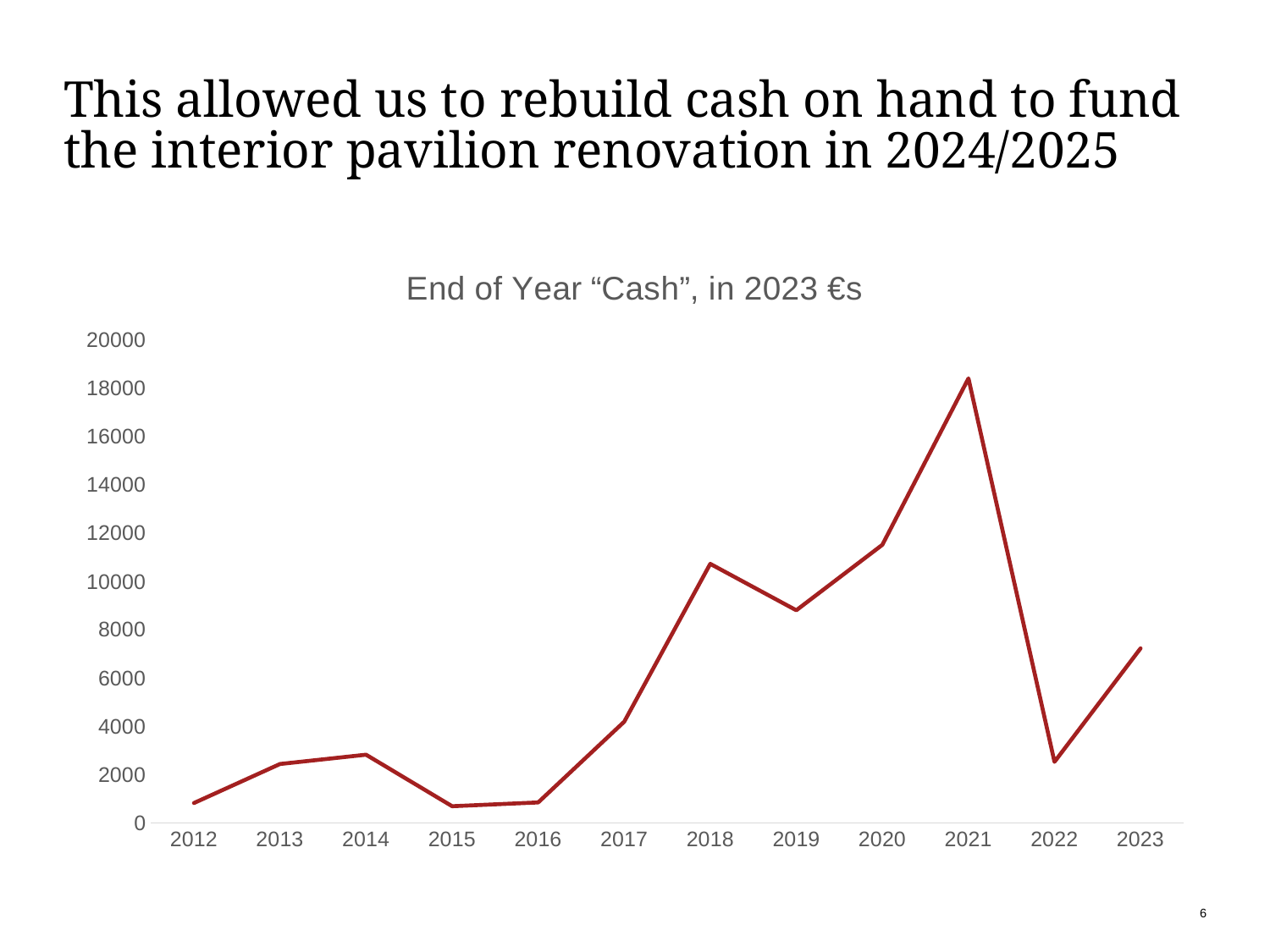
What is the title of the chart? End of Year "Cash", in 2023 €s Is the value for 2022 greater or less than 4000? less What kind of chart is shown on the slide? Line chart Does the value rise or fall from 2021 to 2022? Fall Is the value for 2018 greater or less than 10000? greater Which year has the larger value, 2020 or 2023? 2020 Which year has the larger value, 2018 or 2019? 2018 Which year has the highest end-of-year cash value? 2021 How many years are plotted on the x axis of the chart? 12 Is the value for 2021 greater or less than 16000? greater Does the value rise or fall from 2015 to 2018? Rise